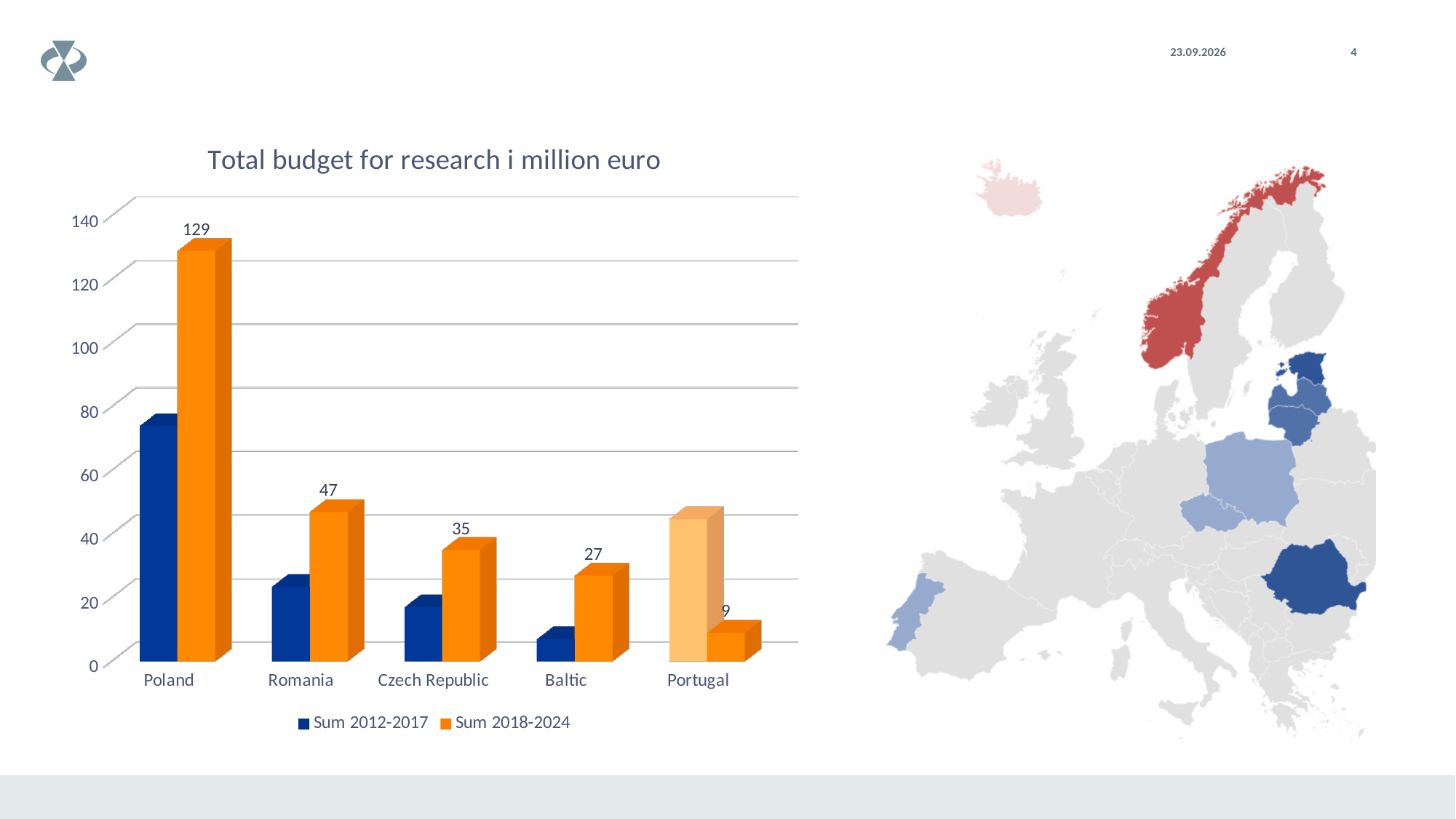
What is the difference between the Sum 2018-2024 values for Poland and Romania? 82 Is the Sum 2012-2017 value for Poland greater or less than 60? greater What is the value for Romania in the Sum 2018-2024 series? 47 How many series does the chart's legend list? 2 Is the Sum 2012-2017 value for Baltic greater or less than 20? less How many categories are shown on the x axis of the chart? 5 What is the value for Poland in the Sum 2018-2024 series? 129 Which category has the lowest value in the Sum 2018-2024 series? Portugal Which category has the highest value in the Sum 2018-2024 series? Poland In the Sum 2018-2024 series, which is larger: Czech Republic or Baltic? Czech Republic What is the value for Portugal in the Sum 2018-2024 series? 9 What is the value for Czech Republic in the Sum 2018-2024 series? 35